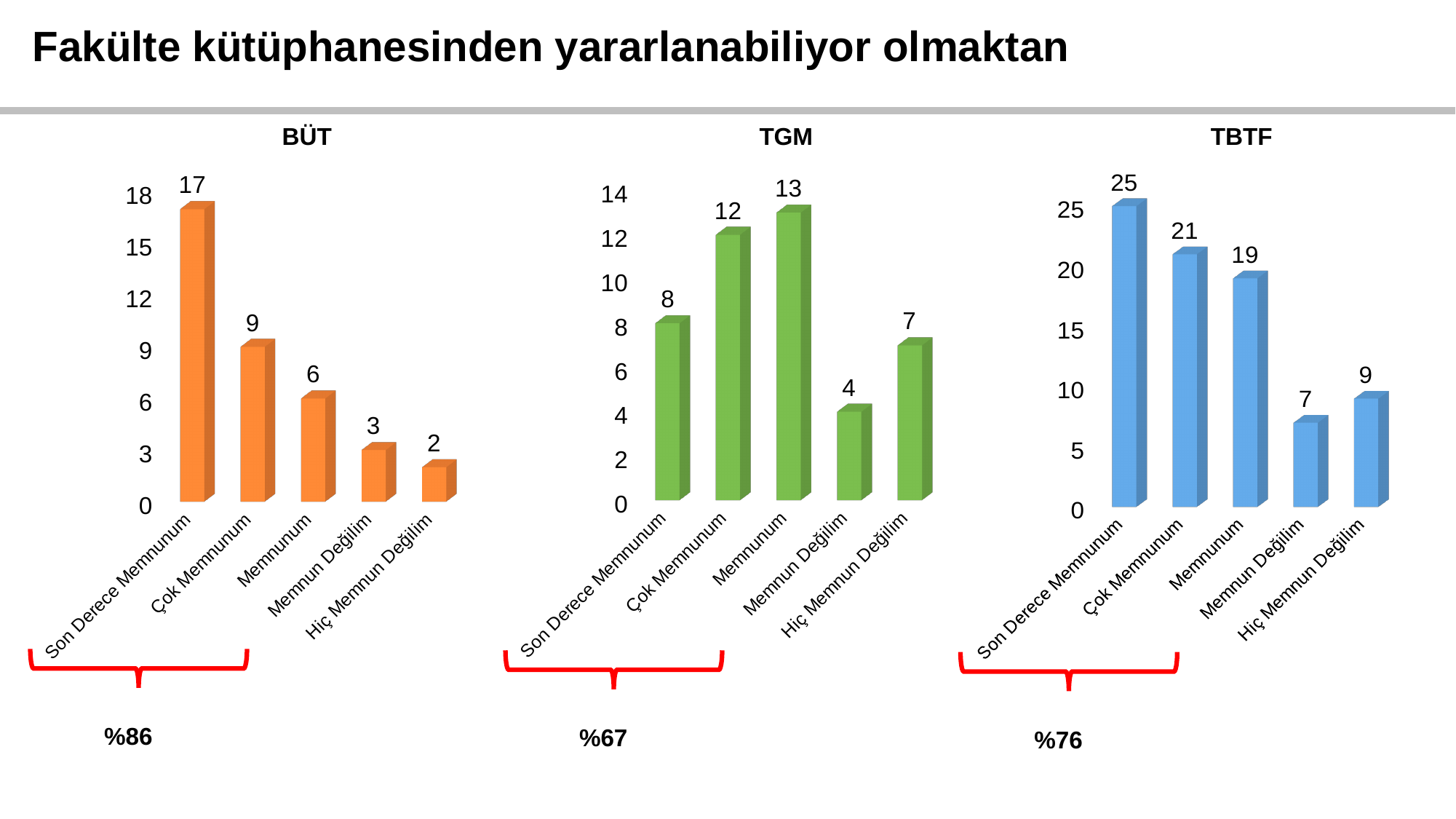
In the TGM chart, what is the value for Memnunum? 13 In the BÜT chart, do the values rise or fall from left to right along the x axis? Fall In the TGM chart, which is larger: Son Derece Memnunum or Hiç Memnun Değilim? Son Derece Memnunum In the TBTF chart, what is the difference between Son Derece Memnunum and Memnunum? 6 In the BÜT chart, what is the value for Son Derece Memnunum? 17 In the TGM chart, which category has the highest value? Memnunum In the TBTF chart, what is the value for Çok Memnunum? 21 In the BÜT chart, which category has the lowest value? Hiç Memnun Değilim How many categories does the BÜT chart show? 5 What percentage is shown under the bracket beneath the TBTF chart? %76 What kind of chart is the TGM chart? Bar chart In the TBTF chart, which category has the lowest value? Memnun Değilim